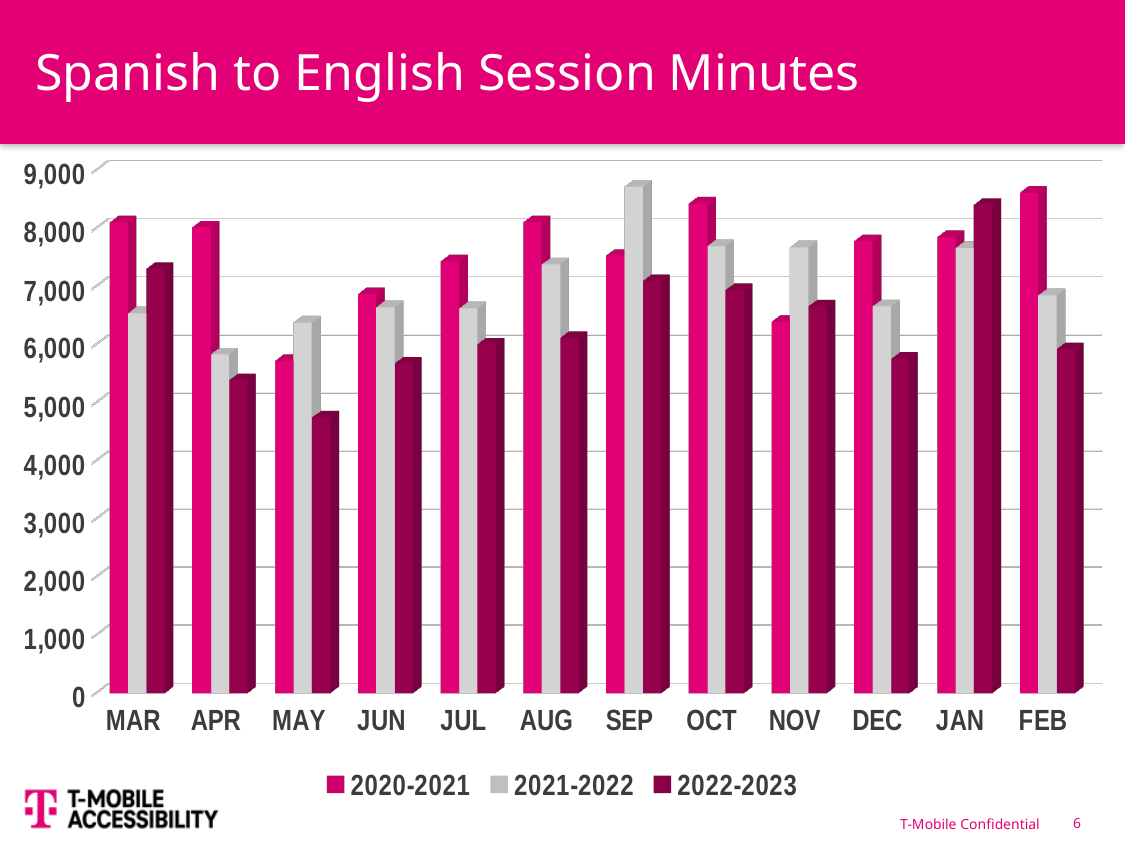
What is the title of the chart on the slide? Spanish to English Session Minutes Which month has the highest value for the 2021-2022 series? SEP Which month has the lowest value for the 2022-2023 series? MAY Is the 2020-2021 value for FEB greater or less than 8,000? greater In MAR, which series has the larger value: 2020-2021 or 2021-2022? 2020-2021 Is the 2021-2022 value for SEP greater or less than 8,000? greater How many series does the chart's legend list? 3 Is the 2022-2023 value for MAY greater or less than 5,000? less What kind of chart is shown on the slide? Bar chart In NOV, which series has the larger value: 2020-2021 or 2021-2022? 2021-2022 Which month has the lowest value for the 2020-2021 series? MAY How many months are shown along the x axis of the chart? 12